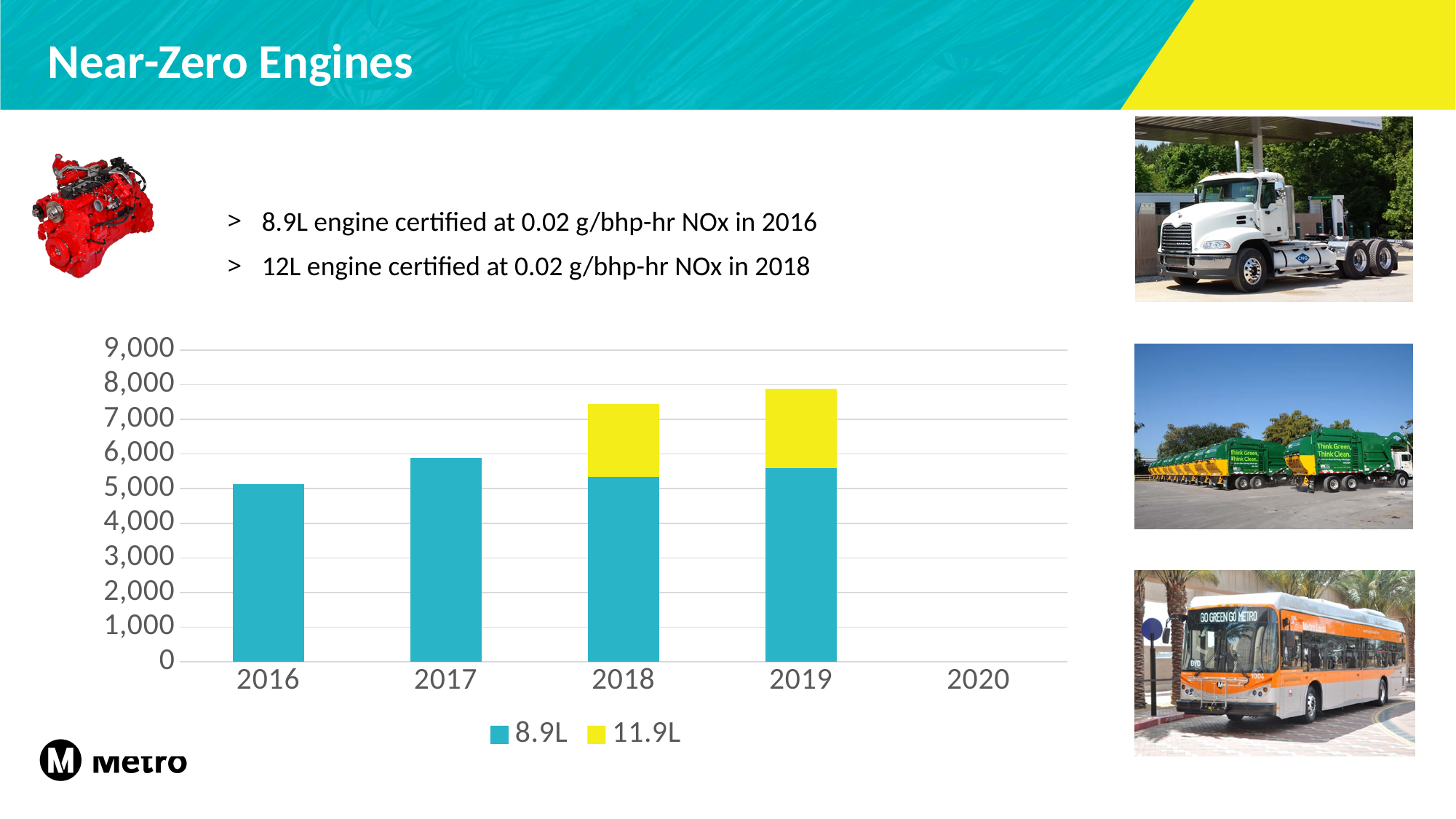
Which year has the shortest bar in the chart? 2016 How many series does the chart legend list? 2 Is the 8.9L value for 2016 greater or less than 6,000? less How many years are shown on the x axis of the chart? 5 Which two series are listed in the chart legend? 8.9L and 11.9L Which year on the x axis has no bar plotted? 2020 Is the total stacked bar for 2019 greater or less than 7,000? greater Which year has the tallest stacked bar in the chart? 2019 Is the total stacked bar for 2018 greater or less than 8,000? less Do the total bar heights rise or fall from 2016 to 2019? Rise What kind of chart is shown on the slide? Stacked bar chart